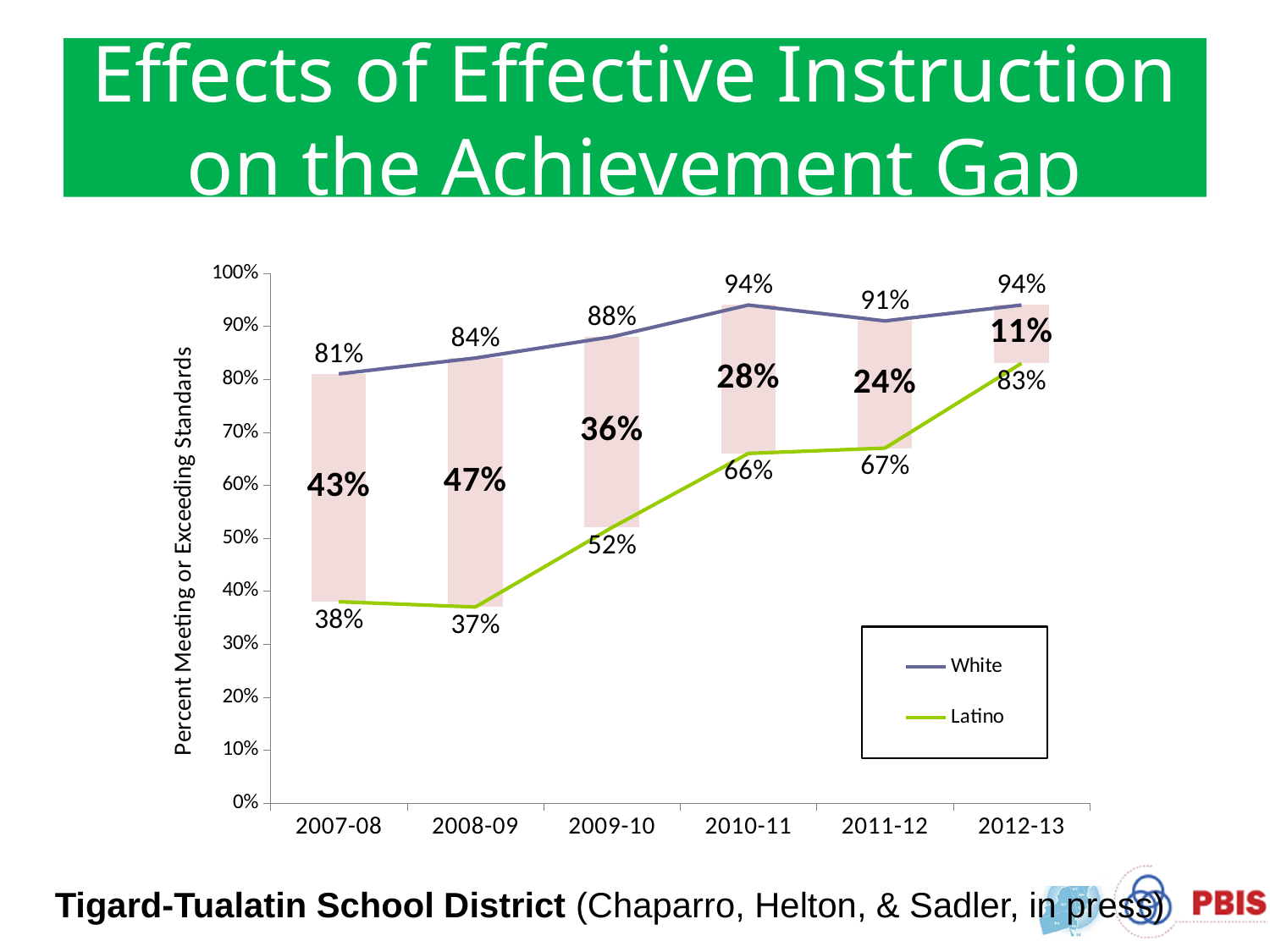
What is the difference between the White and Latino values in 2012-13? 11% Does the Latino value rise or fall from 2008-09 to 2012-13? rise What is the value for Latino in 2012-13? 83% What is the label on the y axis? Percent Meeting or Exceeding Standards What kind of chart is shown? combination bar and line chart How many series does the legend list? 2 What is the difference between the White and Latino values in 2010-11? 28% In which year is the Latino value lowest? 2008-09 How many years are shown on the x axis? 6 Which is larger in 2011-12, the White value or the Latino value? White What is the value for Latino in 2009-10? 52% What is the value for White in 2007-08? 81%